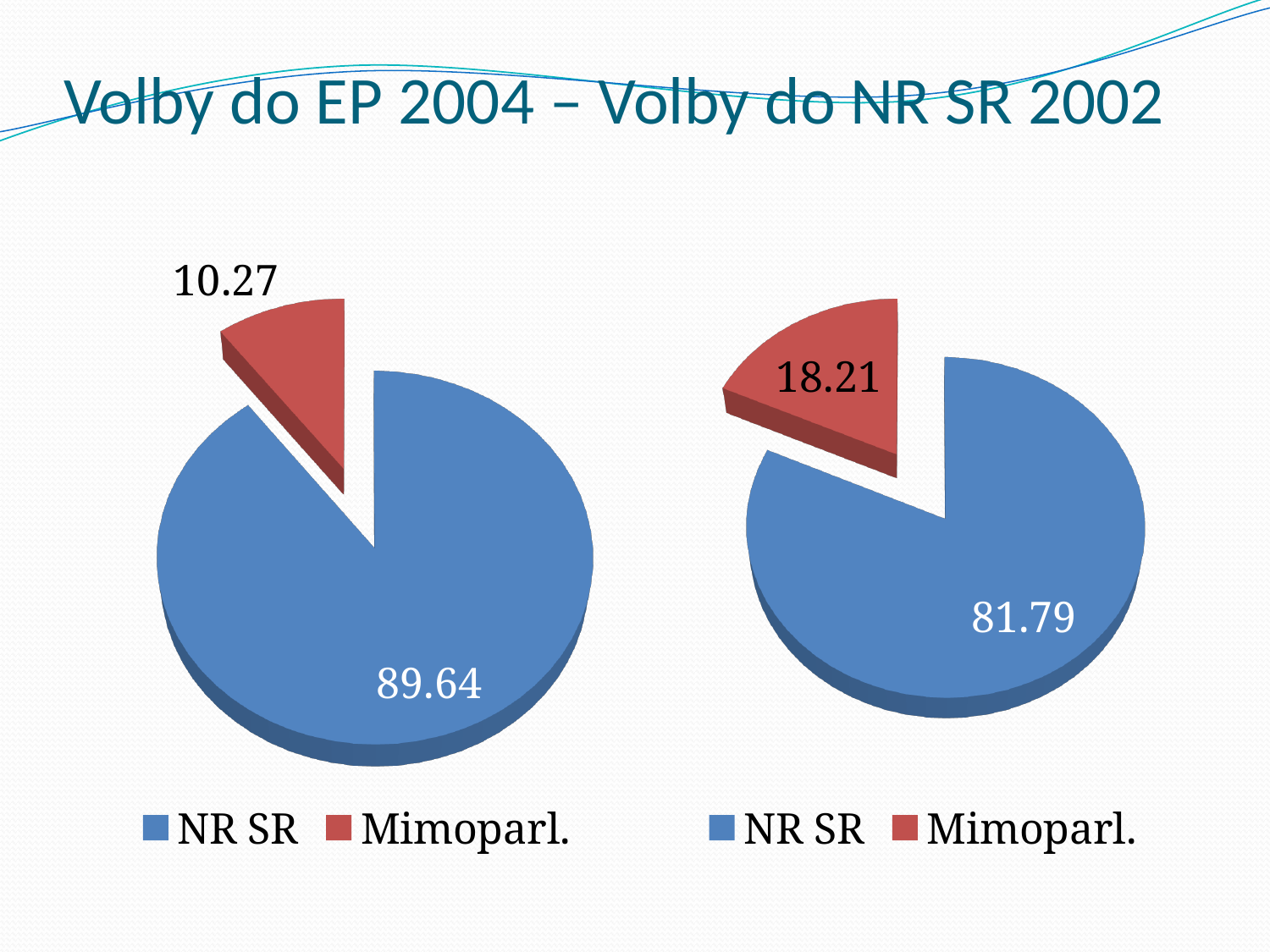
In the right pie chart, what is the difference between the NR SR value and the Mimoparl. value? 63.58 In the left pie chart, which category has the largest slice? NR SR In the right pie chart, which category has the smallest slice? Mimoparl. How many slices does the left pie chart have? 2 What colour is the Mimoparl. slice in the right pie chart? Red In the left pie chart, what is the value for Mimoparl.? 10.27 In the right pie chart, what is the value for NR SR? 81.79 What type of chart is shown on the left of the slide? Pie chart Which is larger: the Mimoparl. value in the left pie chart or the Mimoparl. value in the right pie chart? The right pie chart In the left pie chart, what is the value for NR SR? 89.64 In the right pie chart, what is the value for Mimoparl.? 18.21 How many entries does the legend of the right pie chart list? 2